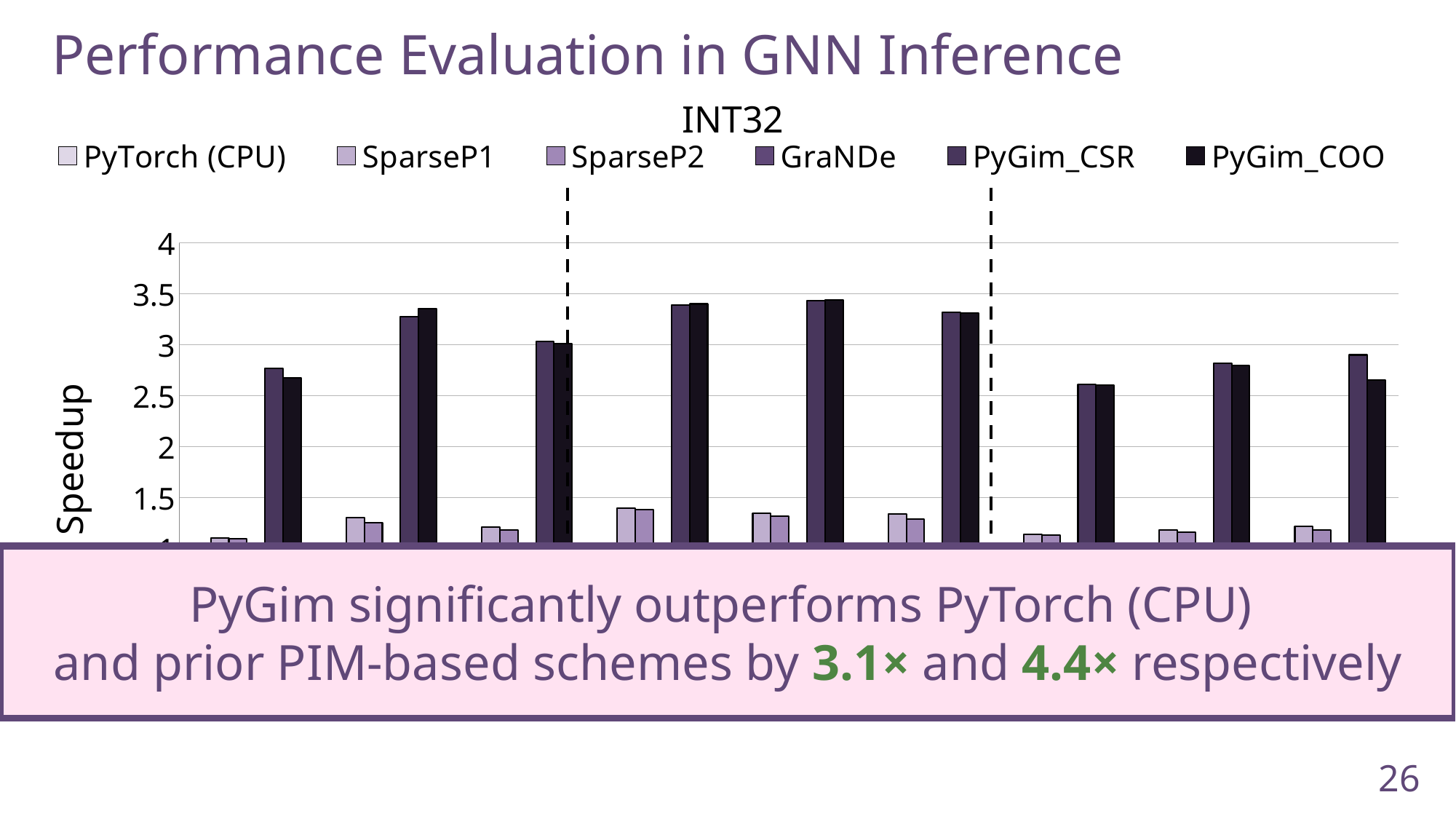
What is the highest value shown on the vertical axis of the chart? 4 How many series does the legend of the chart list? 6 Is the tallest bar in the chart greater or less than 3? greater What is the label on the vertical axis of the chart? Speedup What is the title of the chart? INT32 Is the tallest bar in the chart greater or less than 4? less How many groups of bars are plotted along the x axis of the chart? 9 What kind of chart is shown on the slide? bar chart